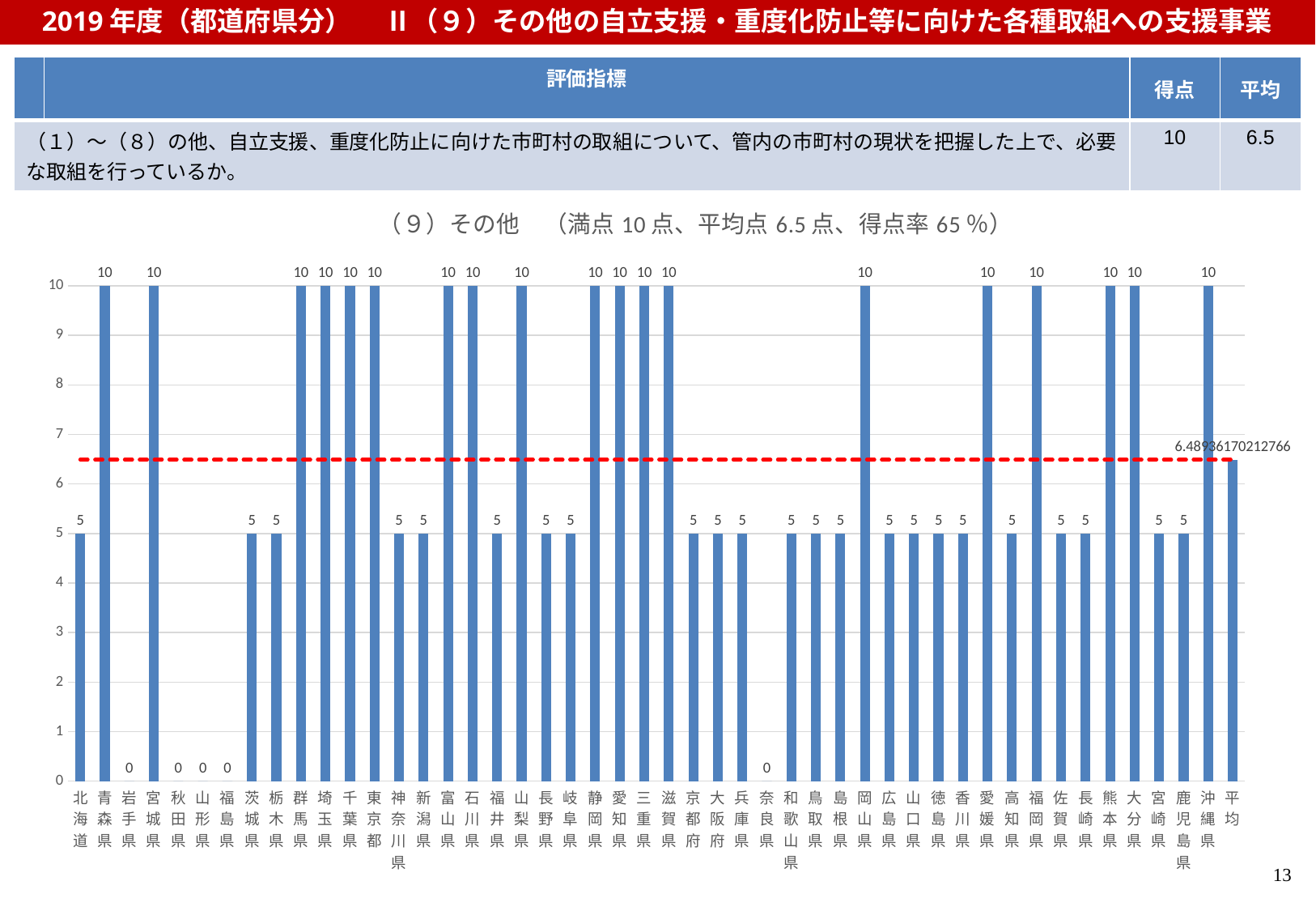
How many prefectures have a value of 0? 5 What is the value for 北海道? 5 What type of chart is shown on the slide? bar chart Is the value for 平均 greater or less than 6? greater What is the difference between the values for 岡山県 and 広島県? 5 Which is larger, the value for 宮城県 or the value for 秋田県? 宮城県 What is the value for 奈良県? 0 What is the value for 青森県? 10 What is the difference between the values for 東京都 and 神奈川県? 5 Which is larger, the value for 沖縄県 or the value for 鹿児島県? 沖縄県 What is the title of the chart? （９）その他 （満点 10 点、平均点 6.5 点、得点率 65 %）